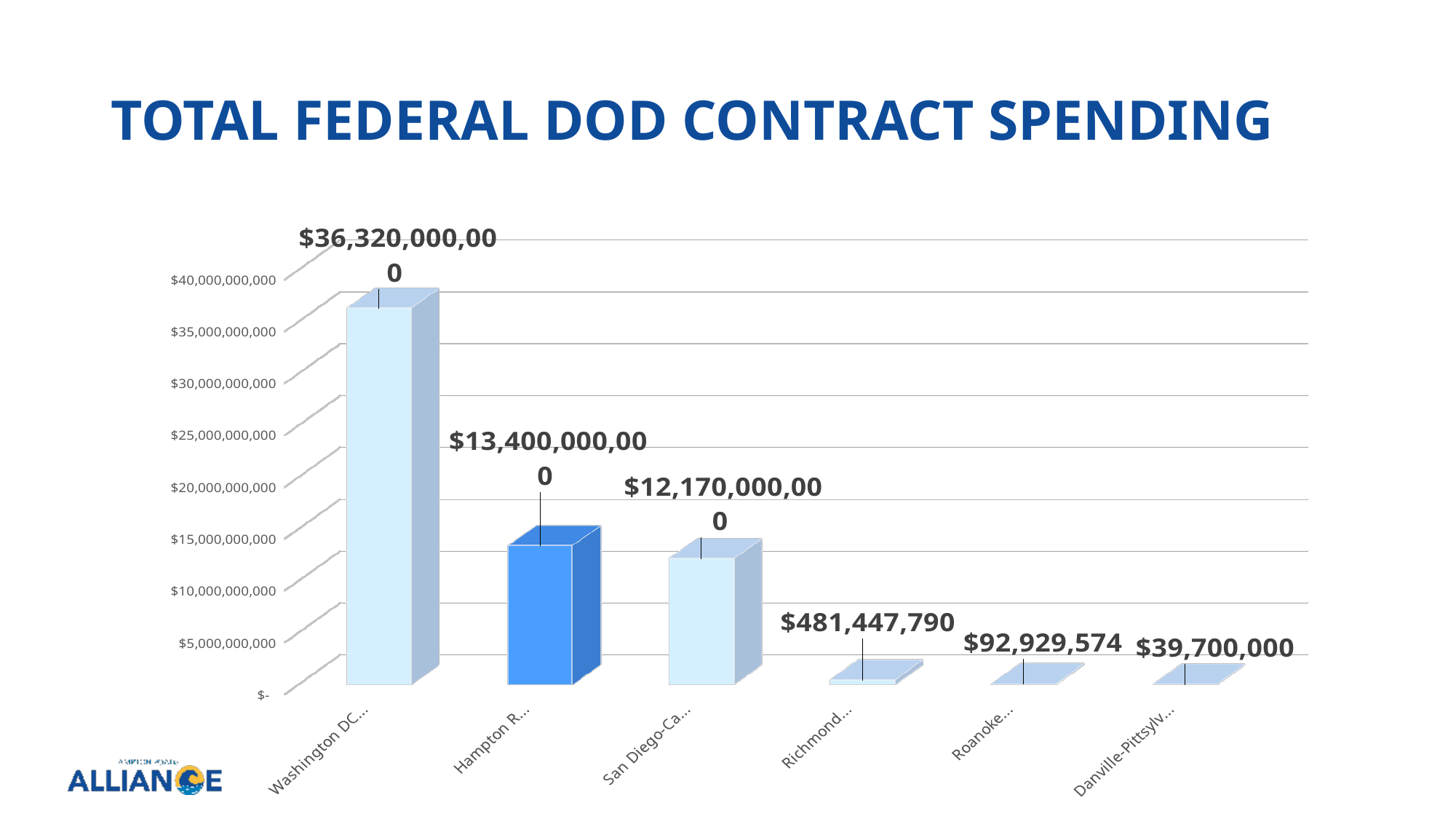
How many categories are shown in the chart? 6 Which is larger, the value for Roanoke... or the value for Danville-Pittsylv...? Roanoke... Which category has the lowest total federal DoD contract spending? Danville-Pittsylv... What is the value for Washington DC in the Total Federal DoD Contract Spending chart? $36,320,000,000 What is the difference between the values for Hampton R... and San Diego-Ca...? $1,230,000,000 What is the value for the Hampton R... category? $13,400,000,000 What kind of chart is shown on the slide? bar chart What is the value for the Roanoke... category? $92,929,574 What is the value for the Richmond... category? $481,447,790 What is the difference between the values for Washington DC and Hampton R...? $22,920,000,000 Which category has the highest total federal DoD contract spending? Washington DC Is the value for Washington DC greater or less than $35,000,000,000? greater